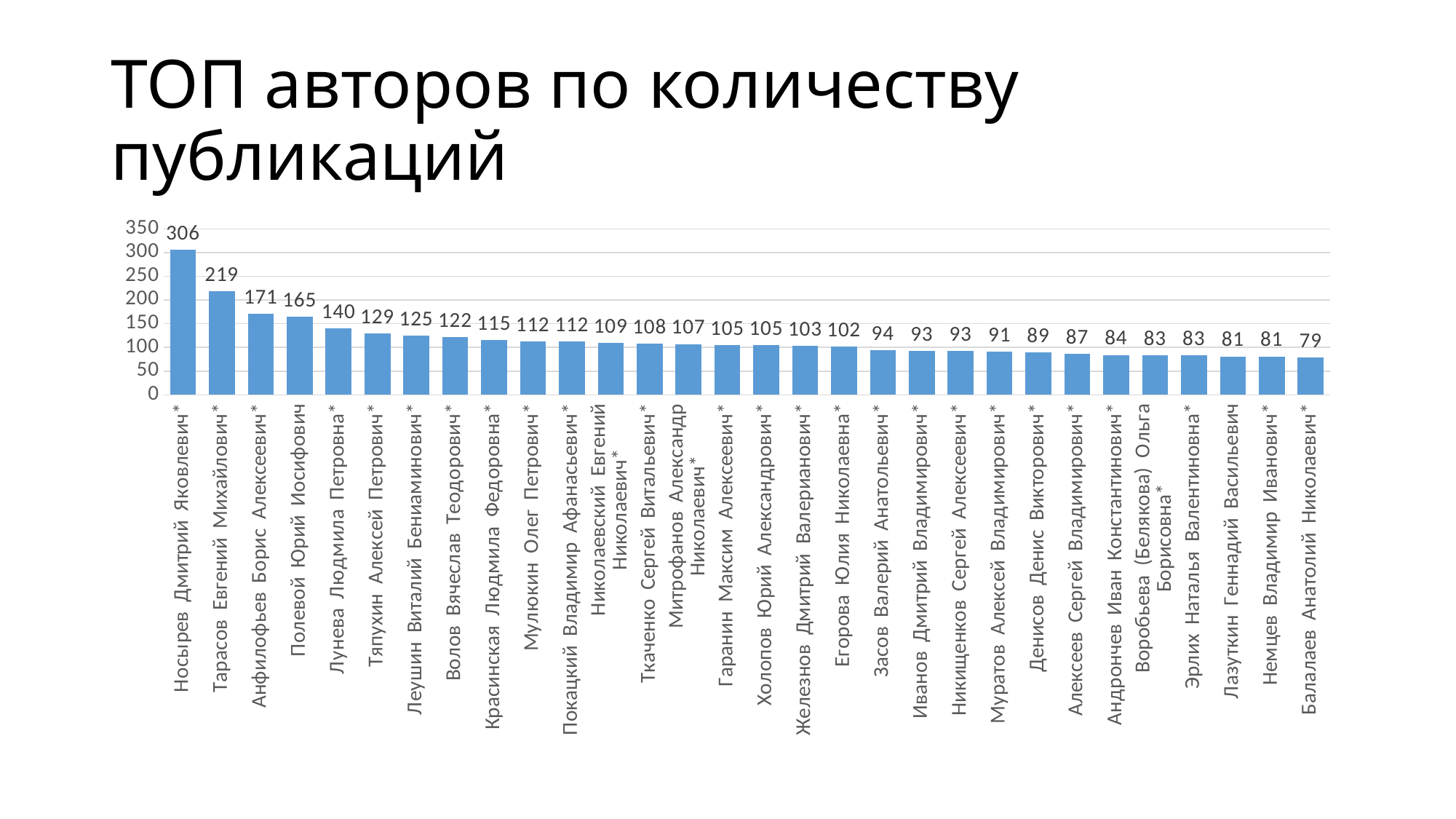
Do the values rise or fall from left to right along the x axis? Fall What is the title of the chart on the slide? ТОП авторов по количеству публикаций Which author has the lowest number of publications? Балалаев Анатолий Николаевич What is the value for Балалаев Анатолий Николаевич? 79 How many authors are shown in the chart? 30 What is the value for Тарасов Евгений Михайлович? 219 What type of chart is shown on the slide? Bar chart Which author has the highest number of publications? Носырев Дмитрий Яковлевич What is the difference between the values for Носырев Дмитрий Яковлевич and Тарасов Евгений Михайлович? 87 What is the value for Лунева Людмила Петровна? 140 Which has a larger value, Анфилофьев Борис Алексеевич or Полевой Юрий Иосифович? Анфилофьев Борис Алексеевич How many publications does Носырев Дмитрий Яковлевич have? 306